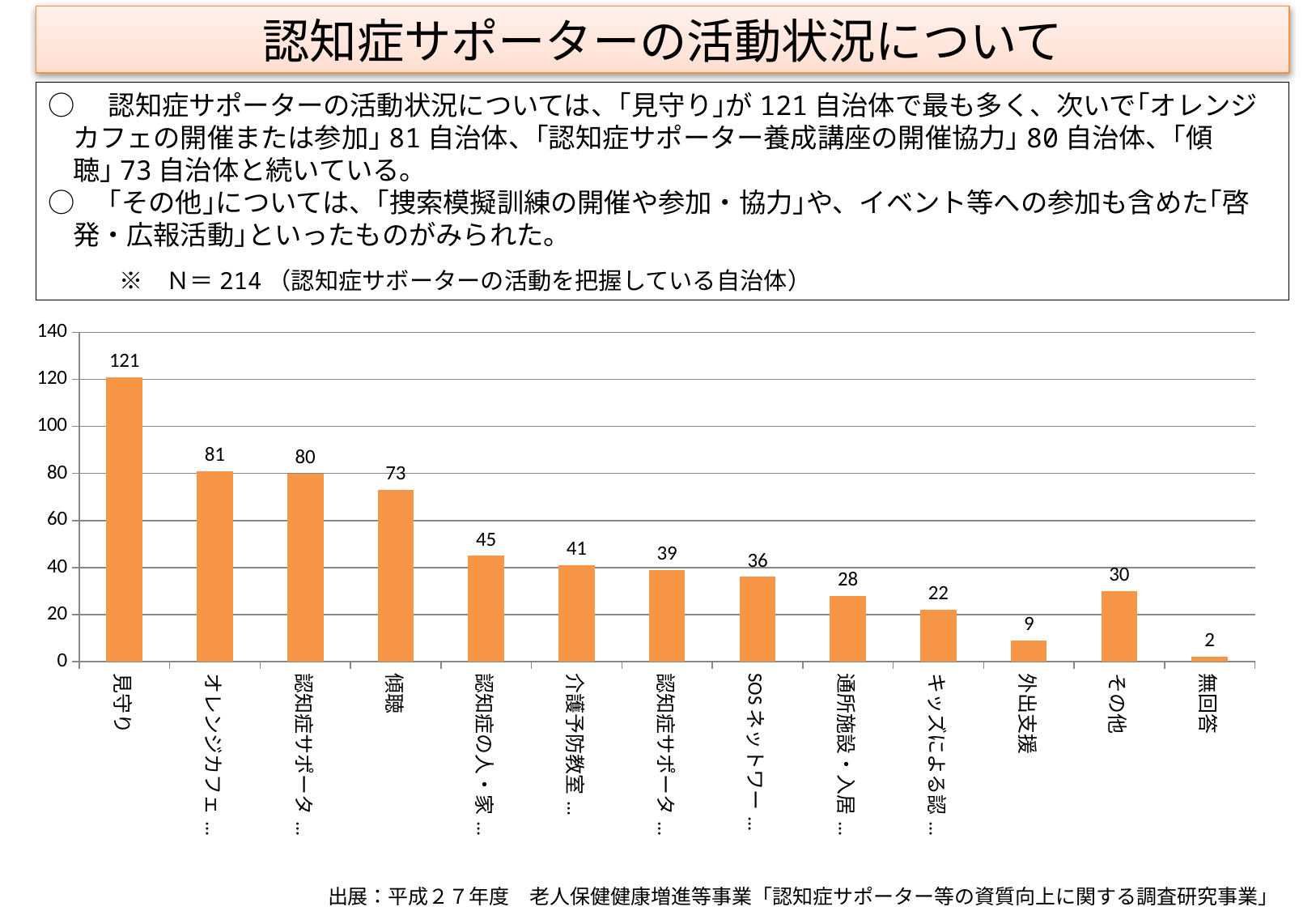
What is the value for 傾聴? 73 What is the value for その他? 30 What is the value for 無回答? 2 What is the difference between the values for 見守り and 傾聴? 48 What is the value for 見守り? 121 What is the value for 外出支援? 9 Which category has the lowest value? 無回答 What type of chart is shown on the slide? bar chart How many categories are shown on the x axis? 13 Which category has the highest value? 見守り Which is larger, the value for その他 or the value for 外出支援? その他 Is the value for 傾聴 greater or less than 80? less